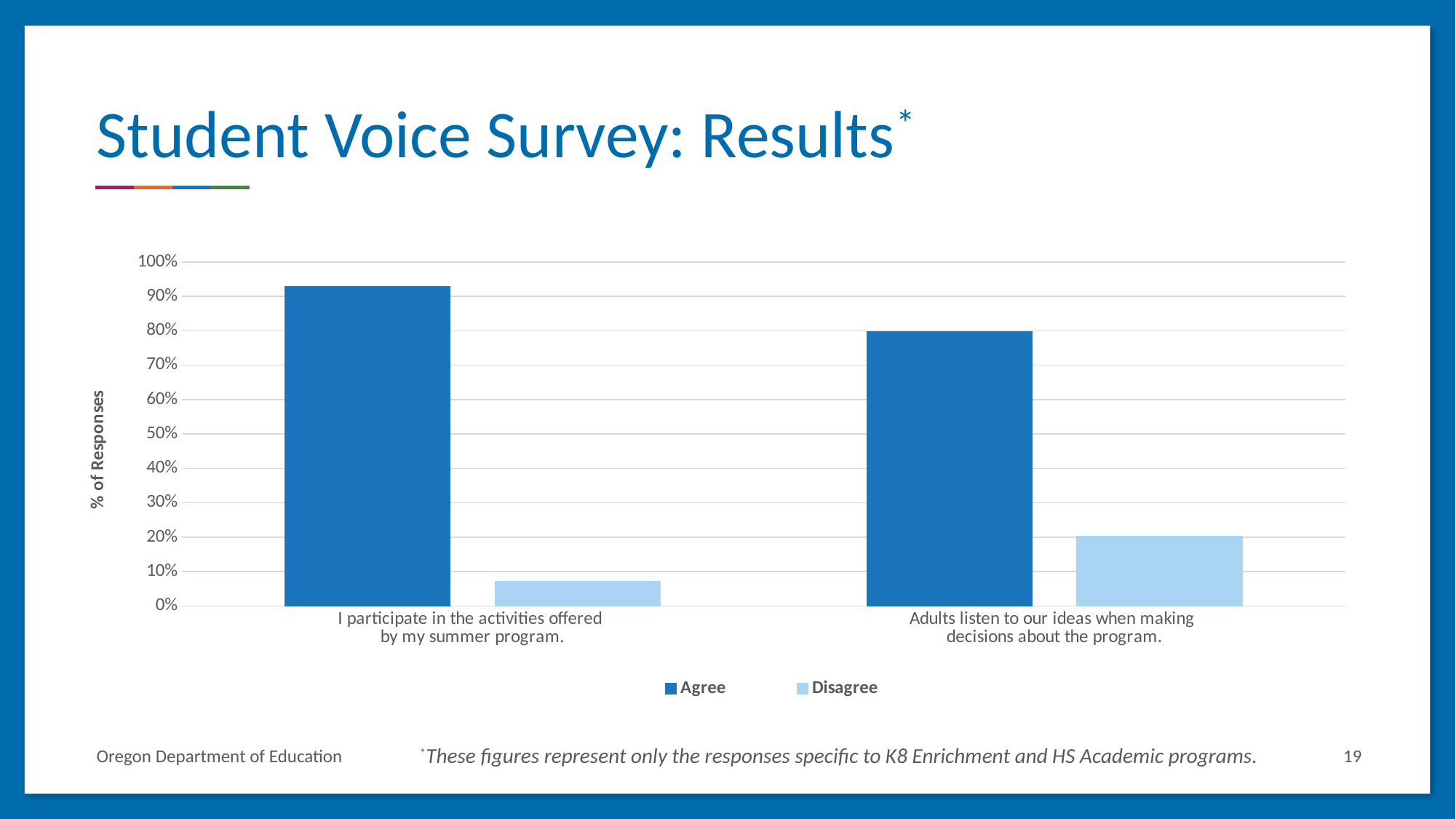
What kind of chart is shown on the slide? bar chart For "Adults listen to our ideas when making decisions about the program.", which is larger, Agree or Disagree? Agree Which series is shown in the lighter blue colour? Disagree Is the Disagree value for "I participate in the activities offered by my summer program." greater or less than 10%? less Is the Agree value for "Adults listen to our ideas when making decisions about the program." greater or less than 70%? greater Is the Disagree value for "Adults listen to our ideas when making decisions about the program." greater or less than 30%? less How many series does the legend list? 2 What is the label on the vertical axis? % of Responses How many survey statements (categories) are shown on the x axis? 2 Which statement has the higher Agree value? I participate in the activities offered by my summer program. Which statement has the lower Disagree value? I participate in the activities offered by my summer program.